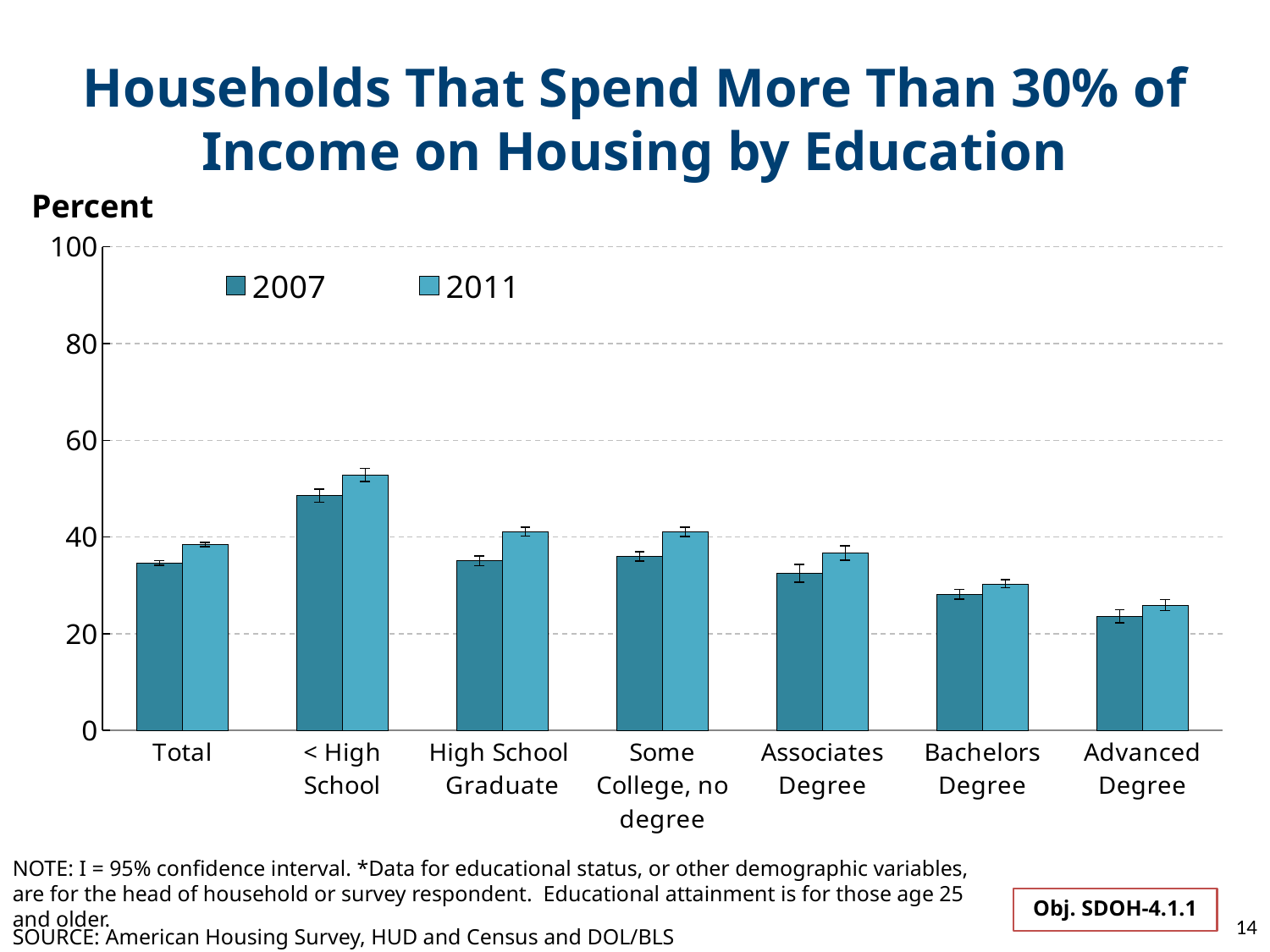
Is the 2007 value for Advanced Degree greater or less than 20? greater What kind of chart is shown on the slide? bar chart Is the 2011 value for < High School greater or less than 40? greater Moving from High School Graduate to Advanced Degree along the x axis, do the 2011 values rise or fall? fall How many education categories are shown on the x axis? 7 How many series does the legend list? 2 Is the 2011 value for Bachelors Degree greater or less than 40? less What label is shown on the vertical axis of the chart? Percent Which education category has the lowest value for 2007? Advanced Degree Which education category has the highest value for 2011? < High School For the Total category, which year has the larger value, 2007 or 2011? 2011